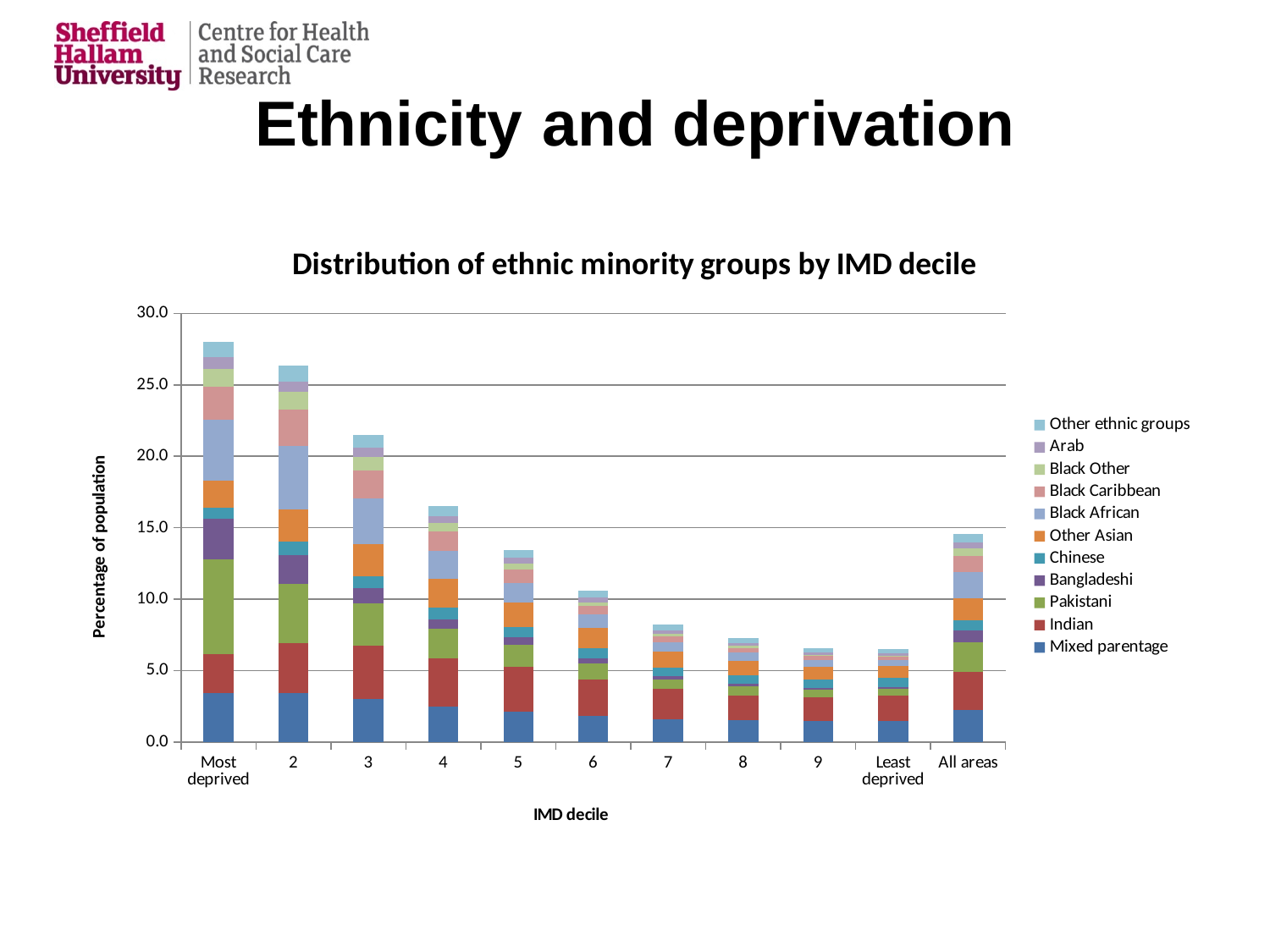
What is the title of the chart? Distribution of ethnic minority groups by IMD decile How many series does the legend list? 11 Is the total for decile 5 greater or less than 15.0? less Is the total for All areas greater or less than 10.0? greater Which has the larger total bar, Most deprived or decile 2? Most deprived How many categories are shown along the x axis? 11 Is the total for decile 8 greater or less than 10.0? less Which category has the highest total bar? Most deprived What is the label of the y axis? Percentage of population What type of chart is shown on the slide? Stacked bar chart Do the total bar heights rise or fall moving from Most deprived to Least deprived along the x axis? fall